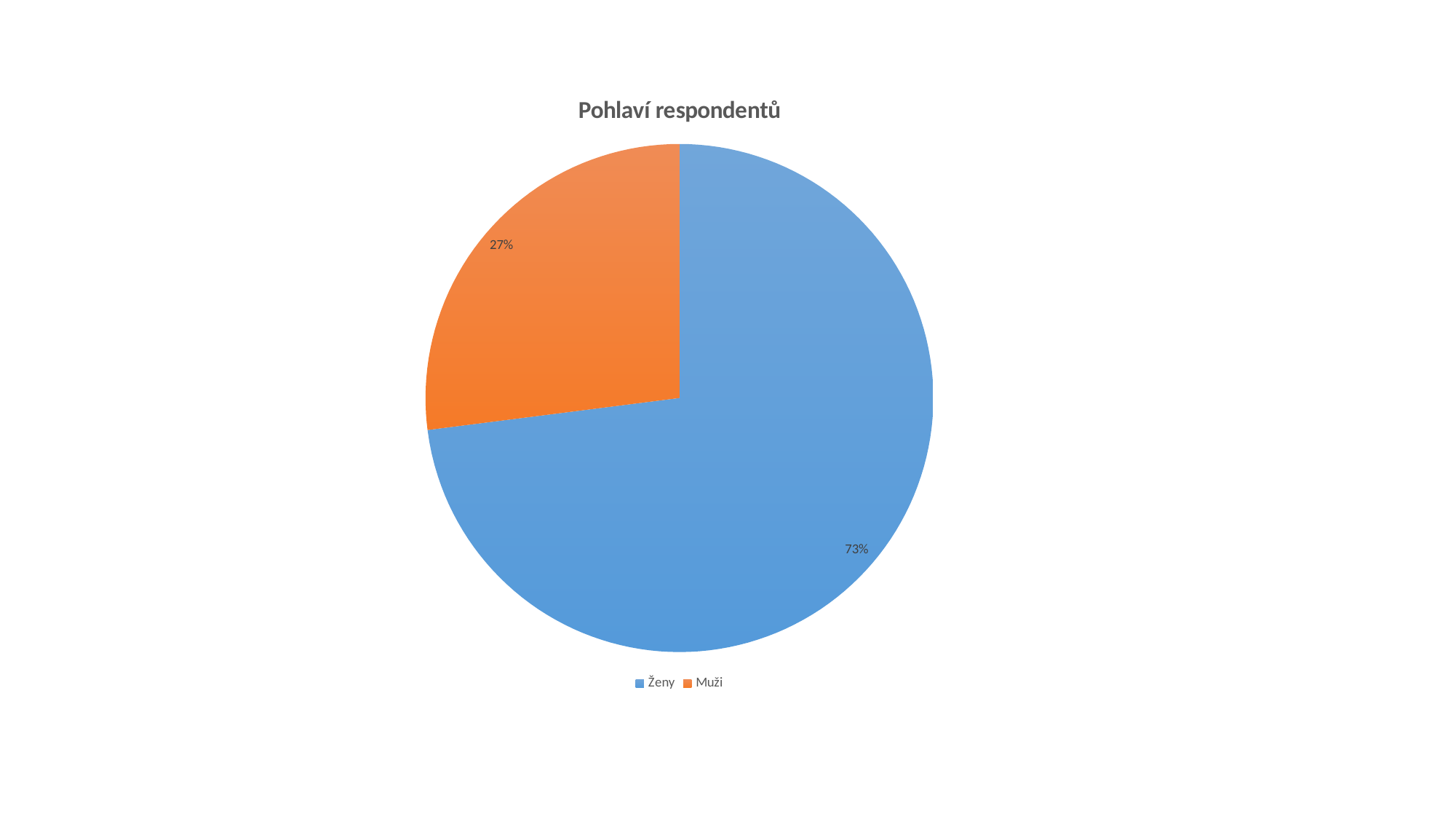
What share of the pie does Muži represent? 27% What is the difference in percentage points between the Ženy and Muži slices? 46 How many categories does the pie chart show? 2 What kind of chart is shown on the slide? pie chart What colour is the Muži slice? orange Which category has the largest slice of the pie? Ženy Is the share for Ženy greater or less than 50%? greater What is the title of the chart? Pohlaví respondentů Which slice is larger, Ženy or Muži? Ženy What share of the pie does Ženy represent? 73% Which category has the smallest slice of the pie? Muži